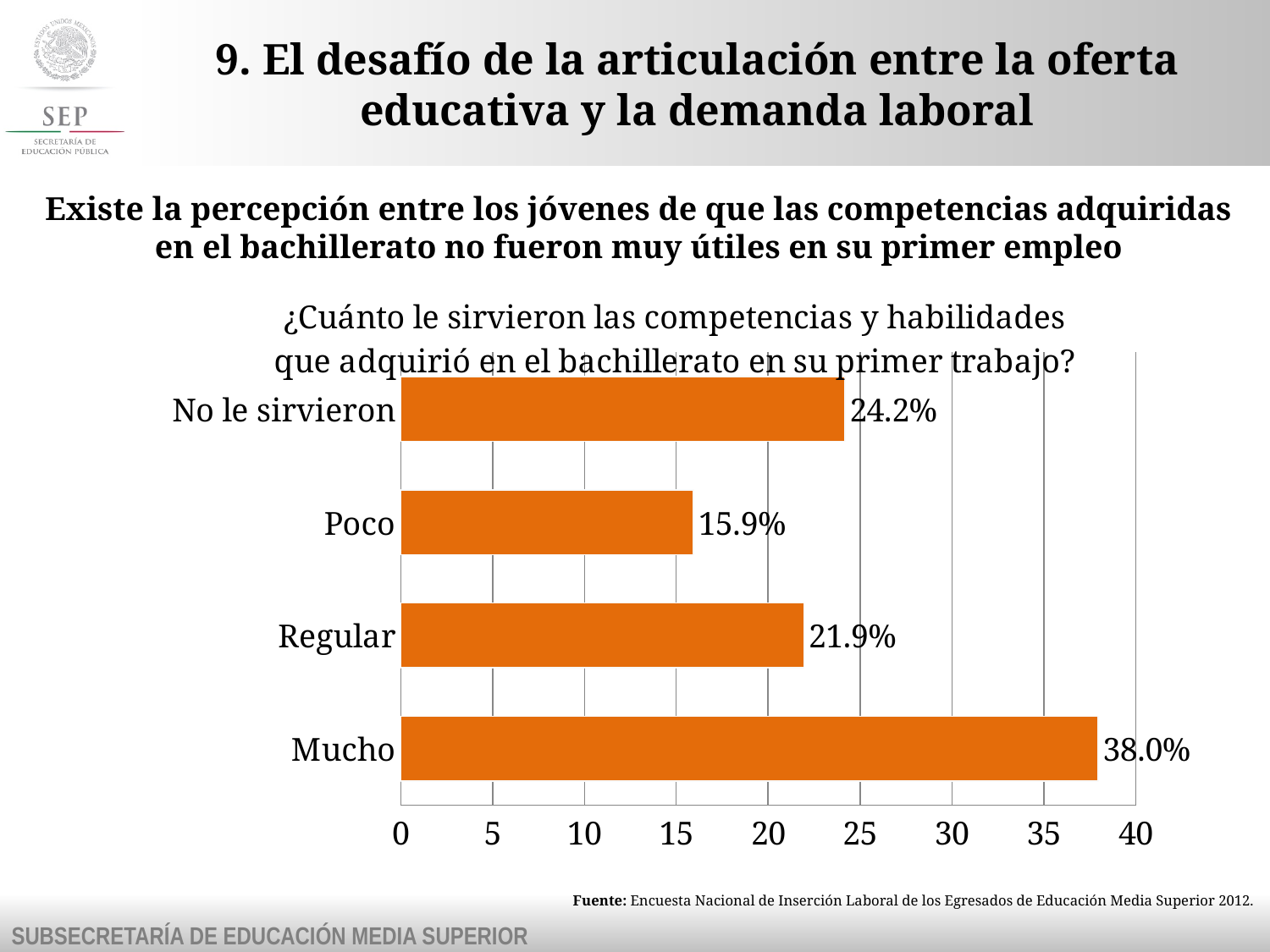
Which category has the highest value? Mucho Which is larger, the value for "No le sirvieron" or the value for "Regular"? No le sirvieron What is the value for "Regular"? 21.9% What is the value for "Poco"? 15.9% What is the title of the chart? ¿Cuánto le sirvieron las competencias y habilidades que adquirió en el bachillerato en su primer trabajo? What kind of chart is shown on the slide? Bar chart What is the difference between the values for "Mucho" and "Poco"? 22.1% What is the value for "Mucho"? 38.0% Is the value for "Regular" greater or less than 20? greater How many categories are shown in the chart? 4 Which category has the lowest value? Poco What is the value for "No le sirvieron"? 24.2%